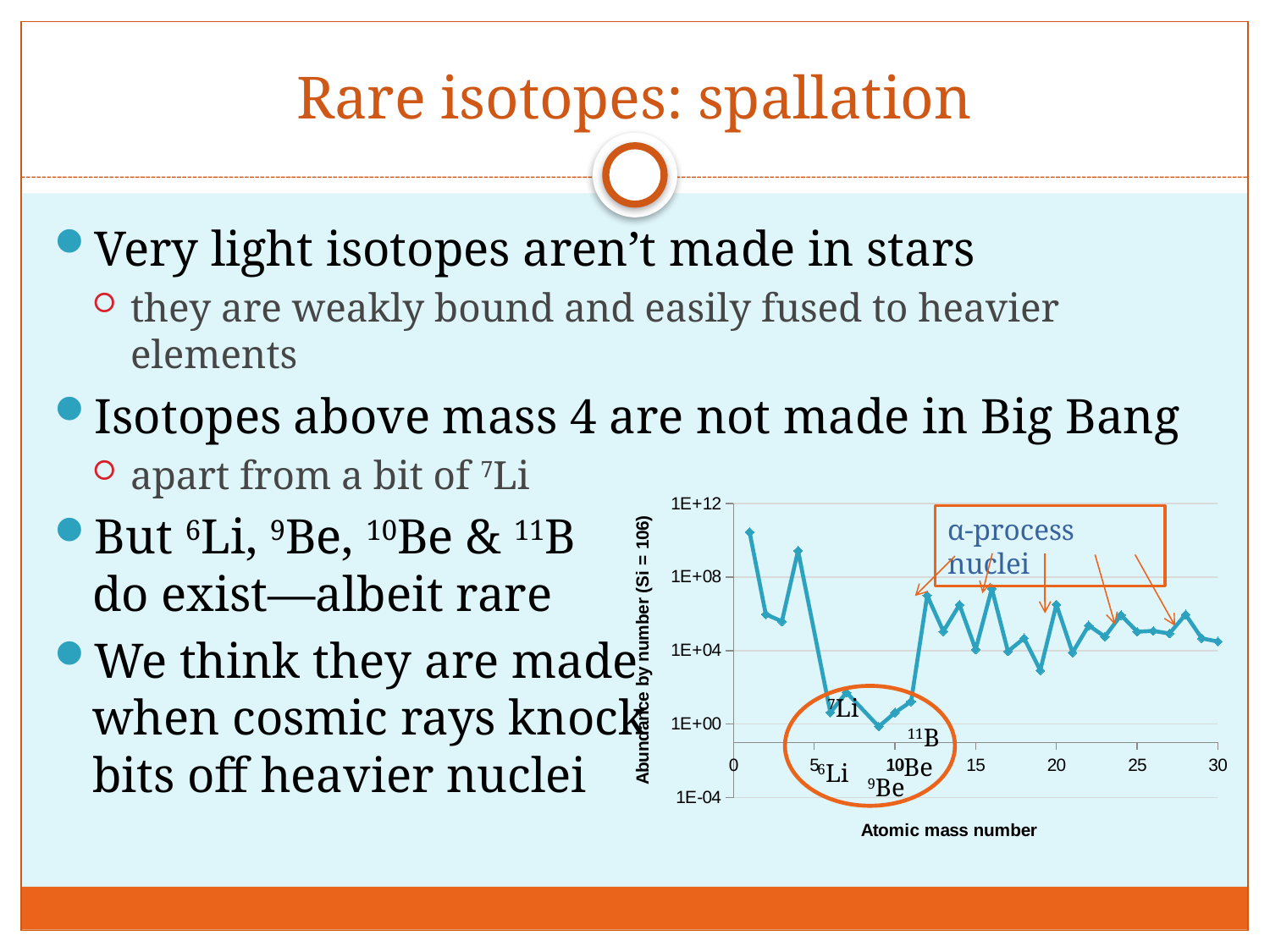
Which has the higher abundance, atomic mass number 4 or atomic mass number 2? 4 Is the abundance at atomic mass number 1 greater or less than 1E+08? greater Do the abundances rise or fall from atomic mass number 4 to atomic mass number 9? fall Which atomic mass number has the highest abundance in the chart? 1 Which atomic mass number has the lowest abundance in the chart? 9 Is the abundance at atomic mass number 9 greater or less than 1E+04? less What label is written in the orange box at the top right of the chart? α-process nuclei What is the title of the x axis of the chart? Atomic mass number Which has the higher abundance, atomic mass number 12 or atomic mass number 9? 12 What kind of chart is shown on the slide? line chart Is the abundance at atomic mass number 4 greater or less than 1E+08? greater